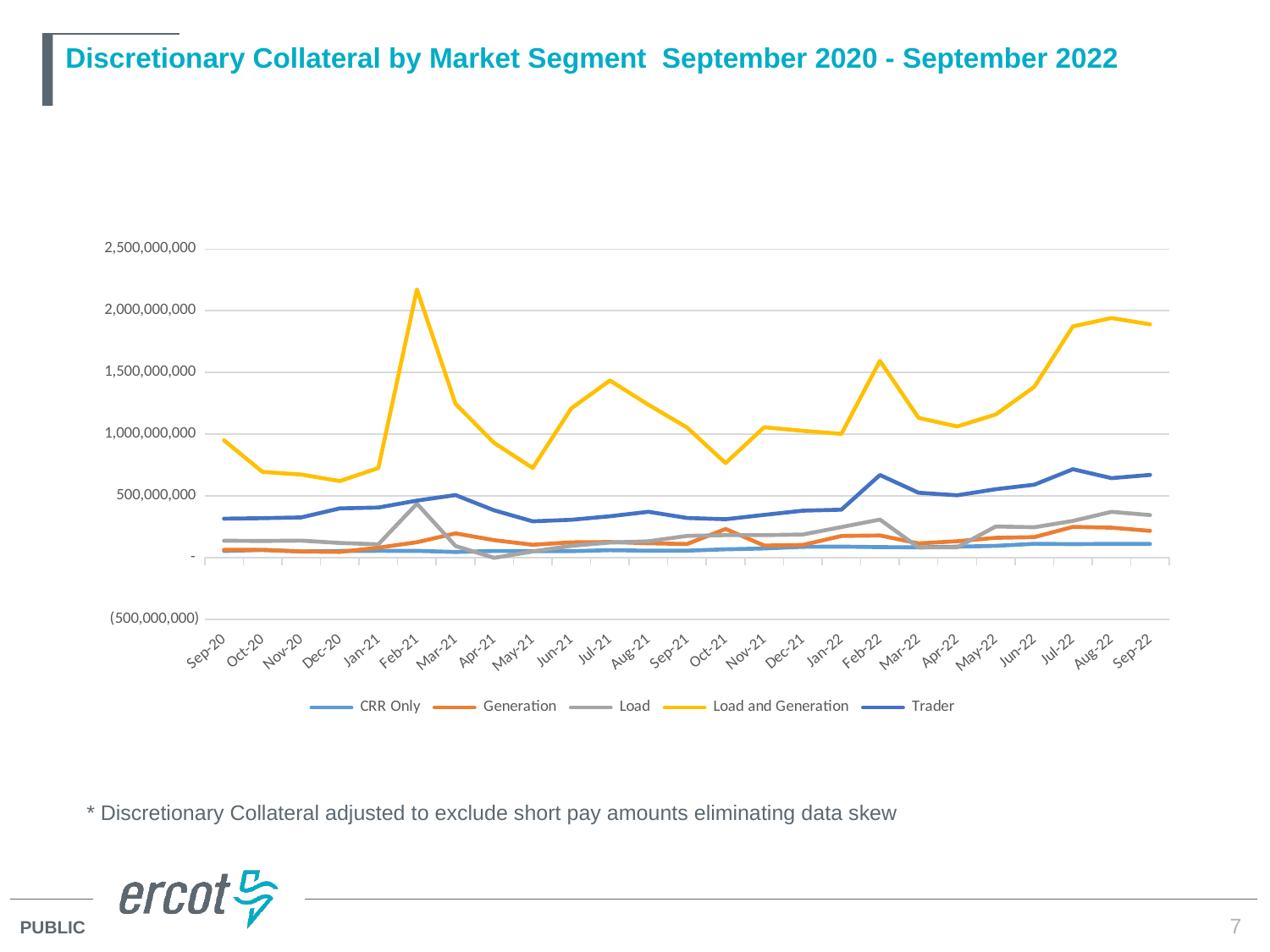
Is the value for Trader in Sep-20 greater or less than 500,000,000? less How many series does the legend list? 5 In Sep-22, which is larger: Load and Generation or Trader? Load and Generation Is the value for Trader in Feb-22 greater or less than 500,000,000? greater Does the Load and Generation series rise or fall from Jun-22 to Aug-22? rise How many months are plotted along the x axis? 25 Which series has the highest values across the chart? Load and Generation What kind of chart is shown on the slide? line chart In which month does the Load and Generation series reach its highest point? Feb-21 Is the value for Load and Generation in Dec-20 greater or less than 1,000,000,000? less What colour is the Load and Generation line in the legend? yellow